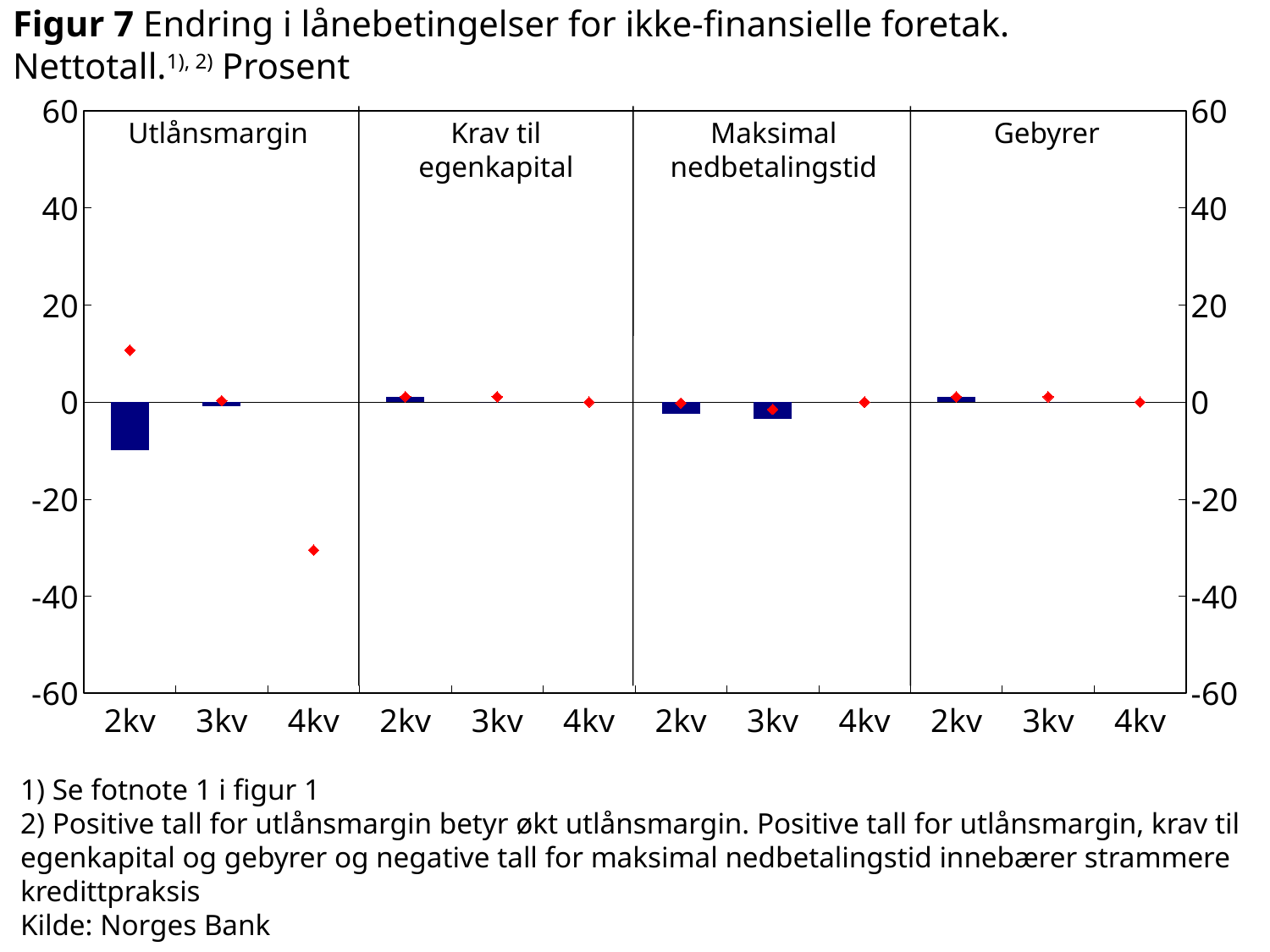
In which panel is the lowest red diamond located? Utlånsmargin Is the bar for 2kv in the Utlånsmargin panel greater or less than -20? greater How many quarters are shown on the x axis within each panel? 3 In which quarter of the Utlånsmargin panel is the bar lowest? 2kv What is the title of the third panel from the left? Maksimal nedbetalingstid What kind of chart is shown in Figur 7? combination chart (bars with diamond markers) Is the red diamond for 2kv in the Utlånsmargin panel greater or less than 0? greater How many panels (loan condition categories) does the chart have? 4 Is the bar for 2kv in the Utlånsmargin panel greater or less than 0? less Which panel contains the lowest bar in the chart? Utlånsmargin Which is lower: the bar for 2kv in the Utlånsmargin panel or the bar for 3kv in the Maksimal nedbetalingstid panel? 2kv in Utlånsmargin